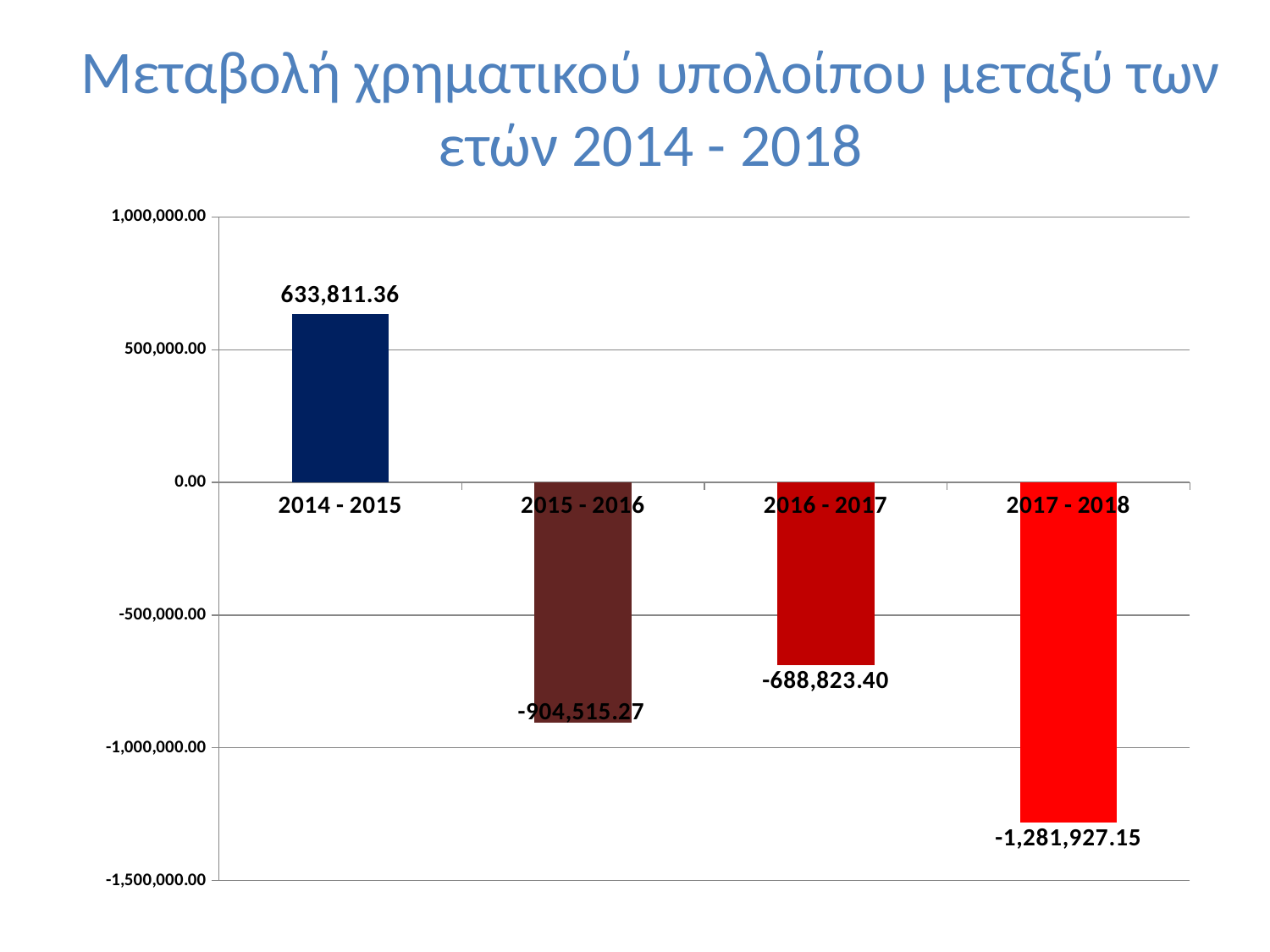
How many periods are shown on the chart? 4 Which period has the highest value? 2014 - 2015 What is the value for 2016 - 2017? -688,823.40 What is the value for 2015 - 2016? -904,515.27 What kind of chart is shown on the slide? Bar chart What is the difference between the values for 2016 - 2017 and 2017 - 2018? 593,103.75 What is the value for 2014 - 2015? 633,811.36 What is the value for 2017 - 2018? -1,281,927.15 Which is larger, the value for 2015 - 2016 or the value for 2016 - 2017? 2016 - 2017 What is the difference between the values for 2016 - 2017 and 2015 - 2016? 215,691.87 Which period has the lowest value? 2017 - 2018 What is the title of the slide? Μεταβολή χρηματικού υπολοίπου μεταξύ των ετών 2014 - 2018